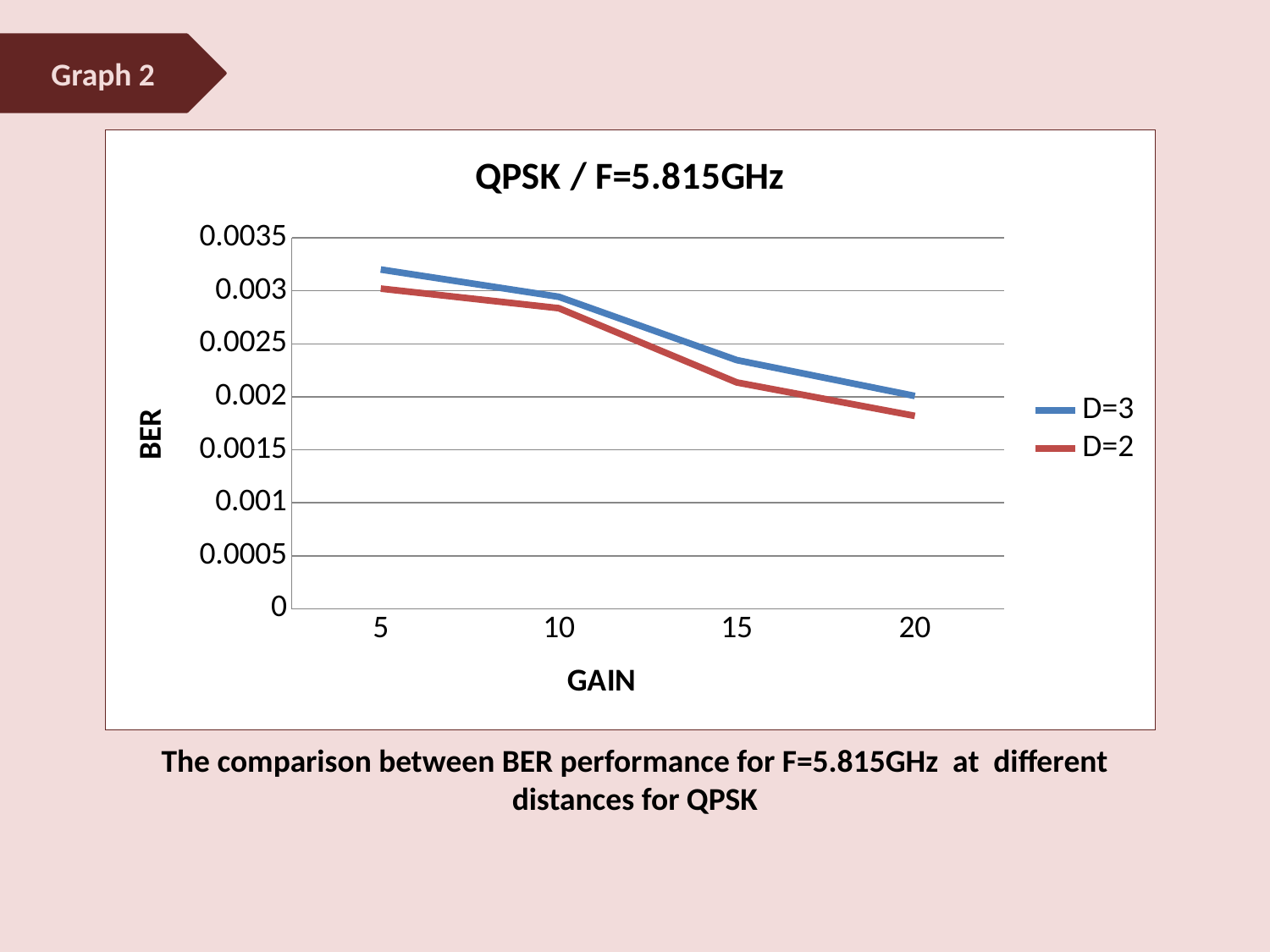
Is the BER for D=2 at GAIN 20 greater or less than 0.002? less How many GAIN values are plotted along the x axis? 4 At which GAIN value is the BER for D=2 lowest? 20 At GAIN 5, which series has the higher BER, D=3 or D=2? D=3 Is the BER for D=3 at GAIN 15 greater or less than 0.0025? less How many series does the legend list? 2 Do the BER values for D=3 rise or fall as GAIN increases? fall What is the title of the chart? QPSK / F=5.815GHz What is the label of the y axis? BER Is the BER for D=3 at GAIN 5 greater or less than 0.003? greater What kind of chart is shown on the slide? line chart At which GAIN value is the BER for D=3 highest? 5